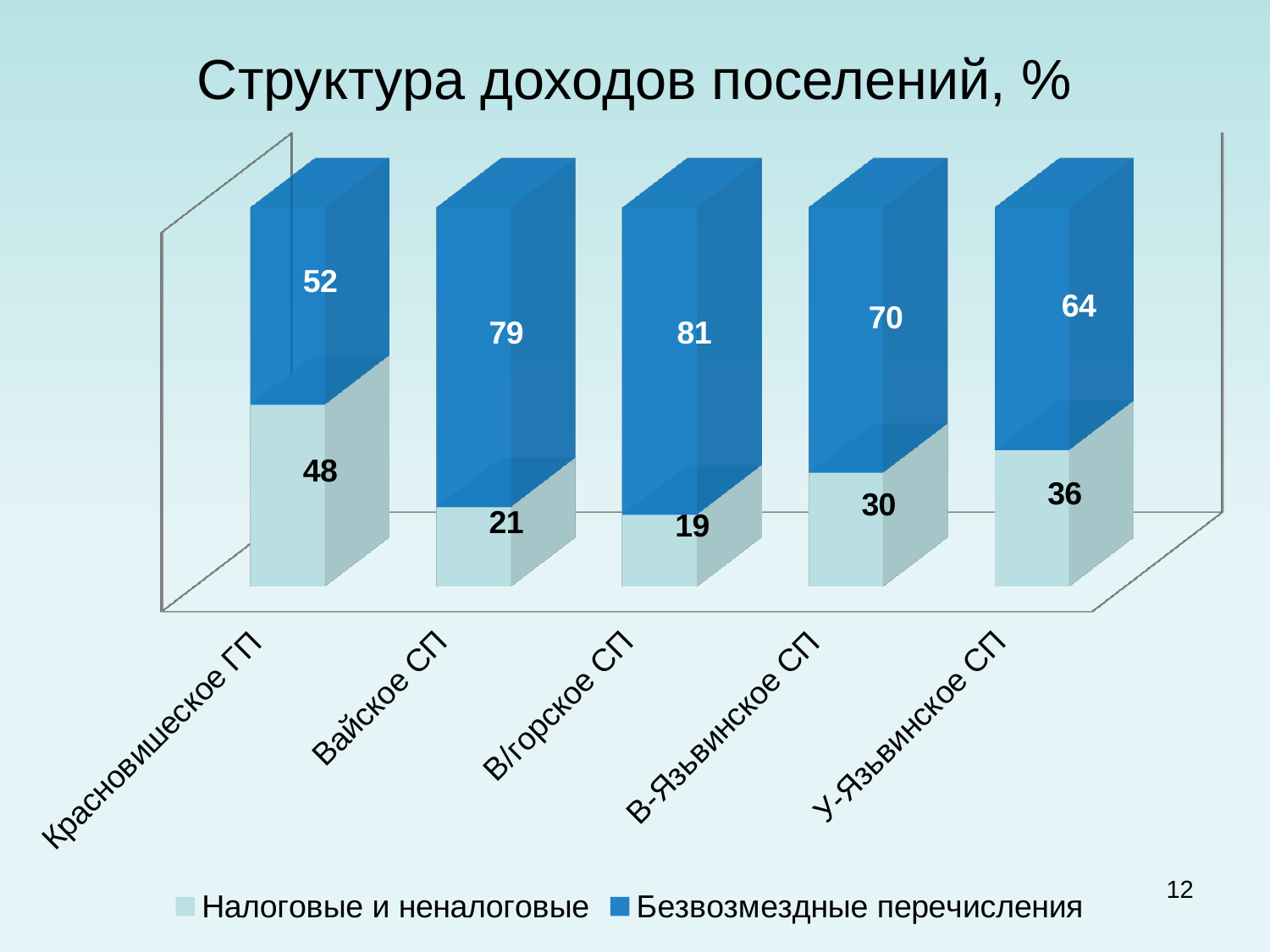
Which is larger: Налоговые и неналоговые for Вайское СП or for В-Язьвинское СП? В-Язьвинское СП What is the value of Налоговые и неналоговые for Красновишерское ГП? 48 What is the value of Налоговые и неналоговые for У-Язьвинское СП? 36 What kind of chart is shown on the slide? Stacked bar chart Which settlement has the lowest value for Налоговые и неналоговые? В/горское СП What is the value of Безвозмездные перечисления for Вайское СП? 79 What is the title of the chart? Структура доходов поселений, % Which settlement has the highest value for Безвозмездные перечисления? В/горское СП How many series does the legend list? 2 What is the difference between the Безвозмездные перечисления values for В-Язьвинское СП and У-Язьвинское СП? 6 What is the total of the stacked bar for Красновишерское ГП? 100 How many settlements are shown on the chart? 5